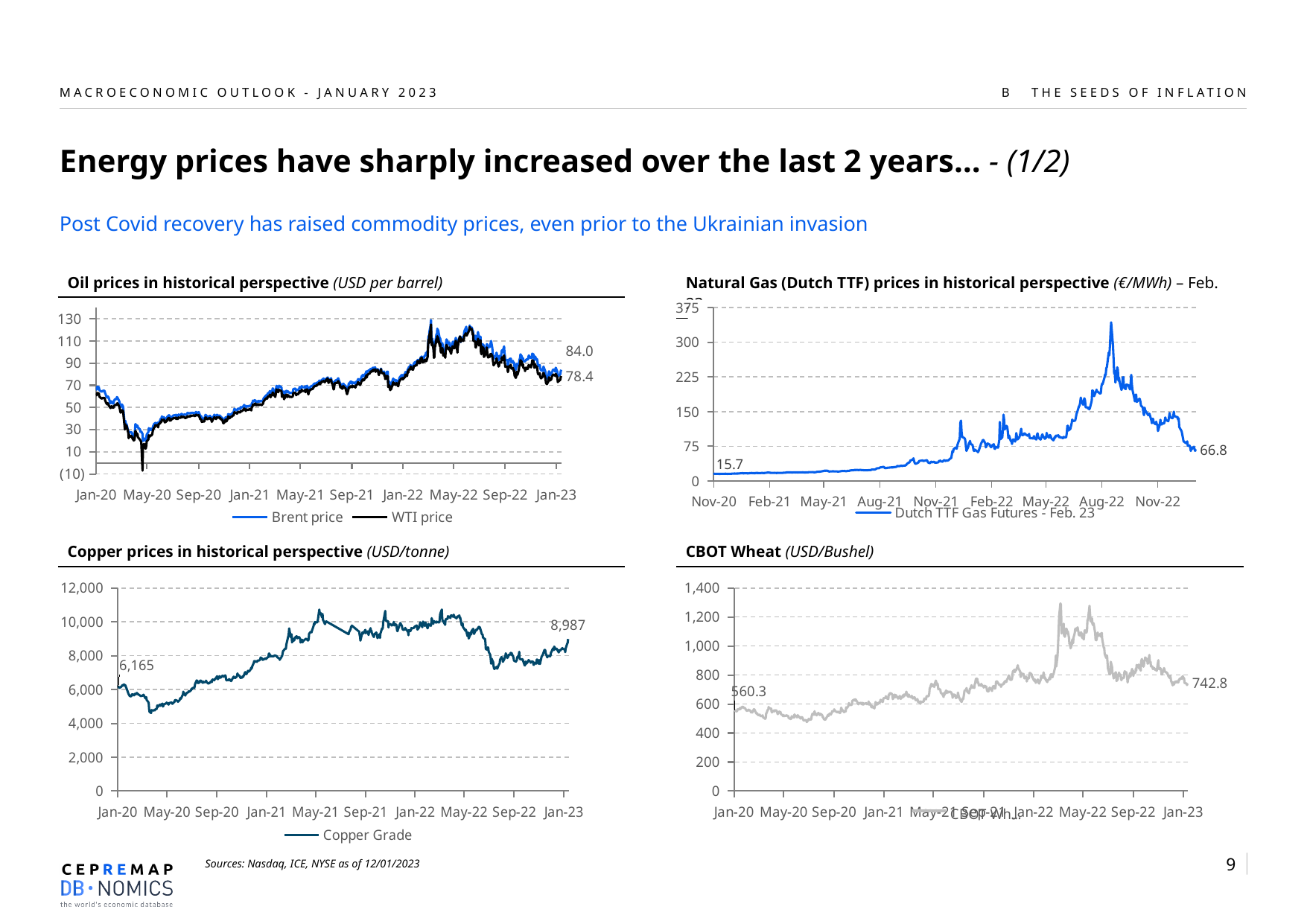
In the 'Natural Gas (Dutch TTF) prices in historical perspective' chart, what is the first labelled value at the start of the series? 15.7 In the 'Copper prices in historical perspective' chart, what is the difference between the last labelled value (8,987) and the first labelled value (6,165)? 2,822 In the 'CBOT Wheat' chart, is the last labelled value (742.8) larger or smaller than the first labelled value (560.3)? larger In the 'Oil prices in historical perspective' chart, what is the latest labelled value for the WTI price? 78.4 In the 'CBOT Wheat' chart, what is the first labelled value? 560.3 In the 'Natural Gas (Dutch TTF) prices in historical perspective' chart, is the peak value greater or less than 300? greater In the 'Oil prices in historical perspective' chart, what is the latest labelled value for the Brent price? 84.0 How many series does the legend of the 'Oil prices in historical perspective' chart list? 2 What type of chart is the 'Copper prices in historical perspective' chart? Line chart In the 'Copper prices in historical perspective' chart, what is the last labelled value? 8,987 In the 'Natural Gas (Dutch TTF) prices in historical perspective' chart, what is the last labelled value? 66.8 In the 'Oil prices in historical perspective' chart, what is the difference between the latest labelled Brent price and WTI price? 5.6